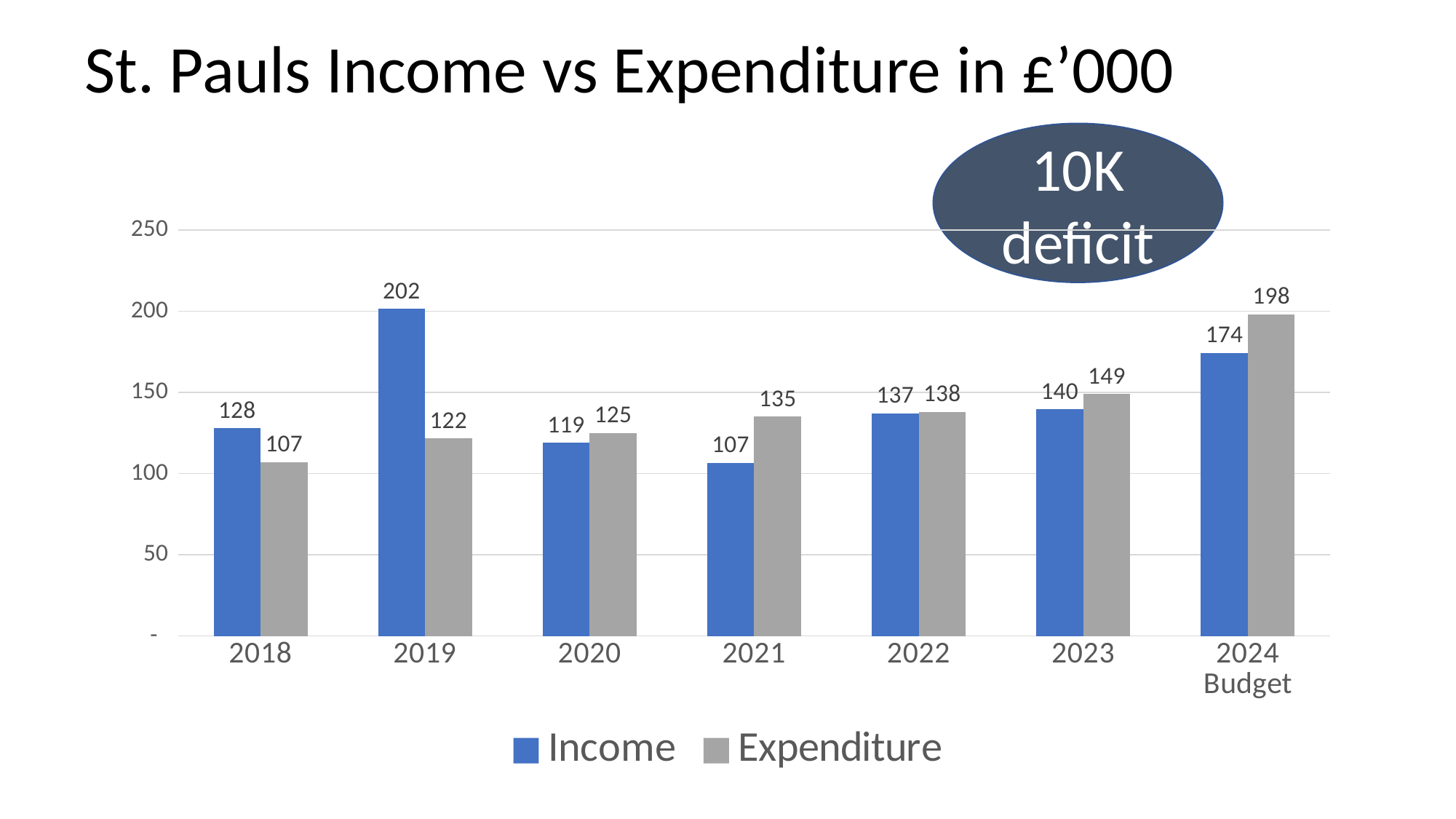
How many series does the legend list? 2 Which year has the highest Income? 2019 Which year has the lowest Expenditure? 2018 What is the difference between Income and Expenditure in 2019? 80 What is the Income value for 2019? 202 How many years are shown on the x axis? 7 What is the difference between Expenditure and Income in the 2024 Budget? 24 What is the title of the chart? St. Pauls Income vs Expenditure in £'000 What is the Income value for 2021? 107 In 2018, which is larger, Income or Expenditure? Income What is the Expenditure value for 2024 Budget? 198 What kind of chart is shown? Bar chart